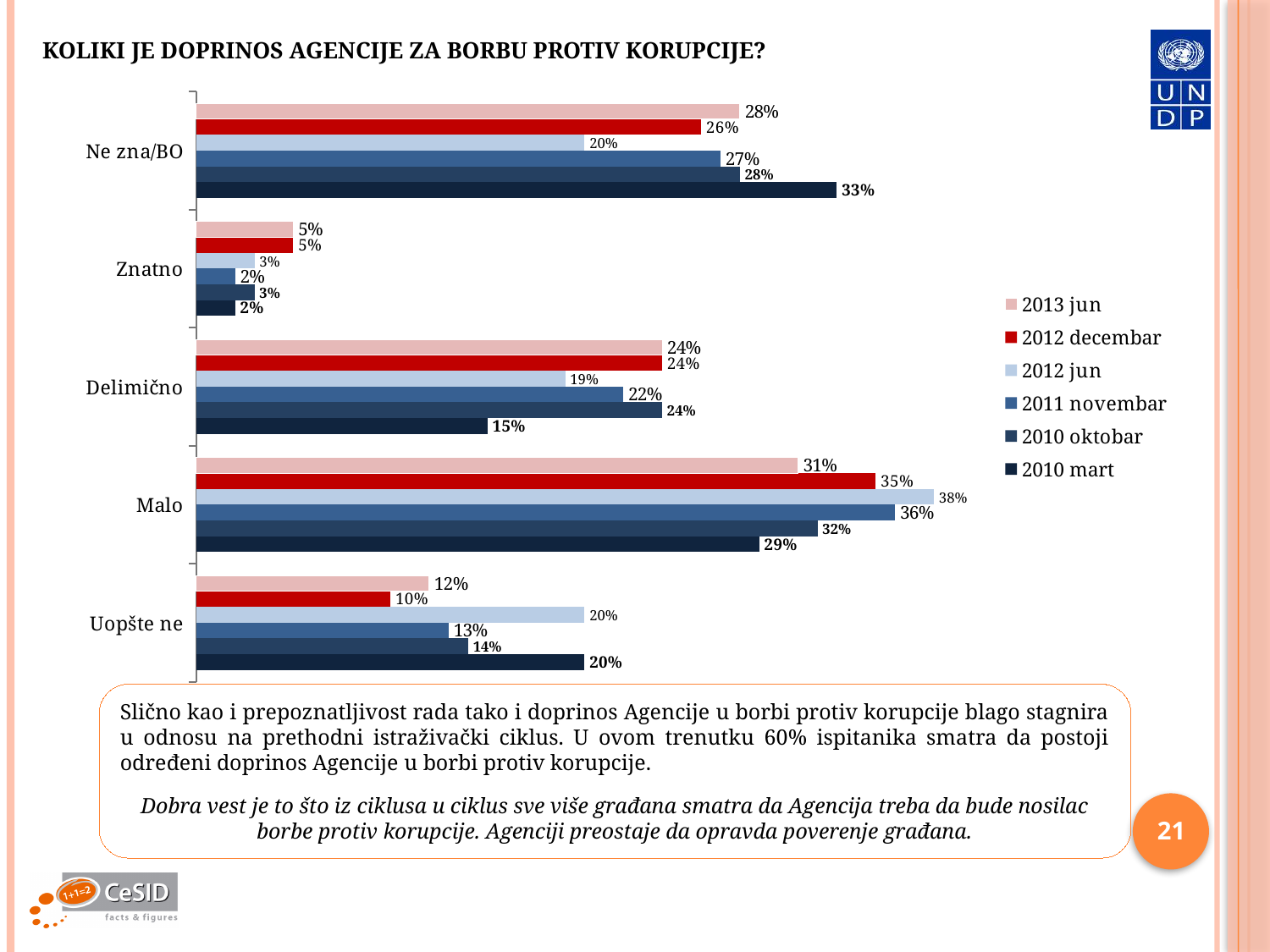
What is the value for "Uopšte ne" in the 2013 jun series? 12% What is the value for "Delimično" in the 2011 novembar series? 22% Which series is shown in the legend with a light pink colour? 2013 jun What kind of chart is shown on the slide? Bar chart Which is larger for "Delimično": the 2013 jun value or the 2010 mart value? 2013 jun Which category has the lowest value in the 2013 jun series? Znatno How many series does the legend list? 6 How many categories are shown on the chart? 5 Which category has the highest value in the 2012 decembar series? Malo What is the value for "Ne zna/BO" in the 2010 mart series? 33% What is the difference between the 2012 jun and 2012 decembar values for "Uopšte ne"? 10% What is the value for "Malo" in the 2012 jun series? 38%